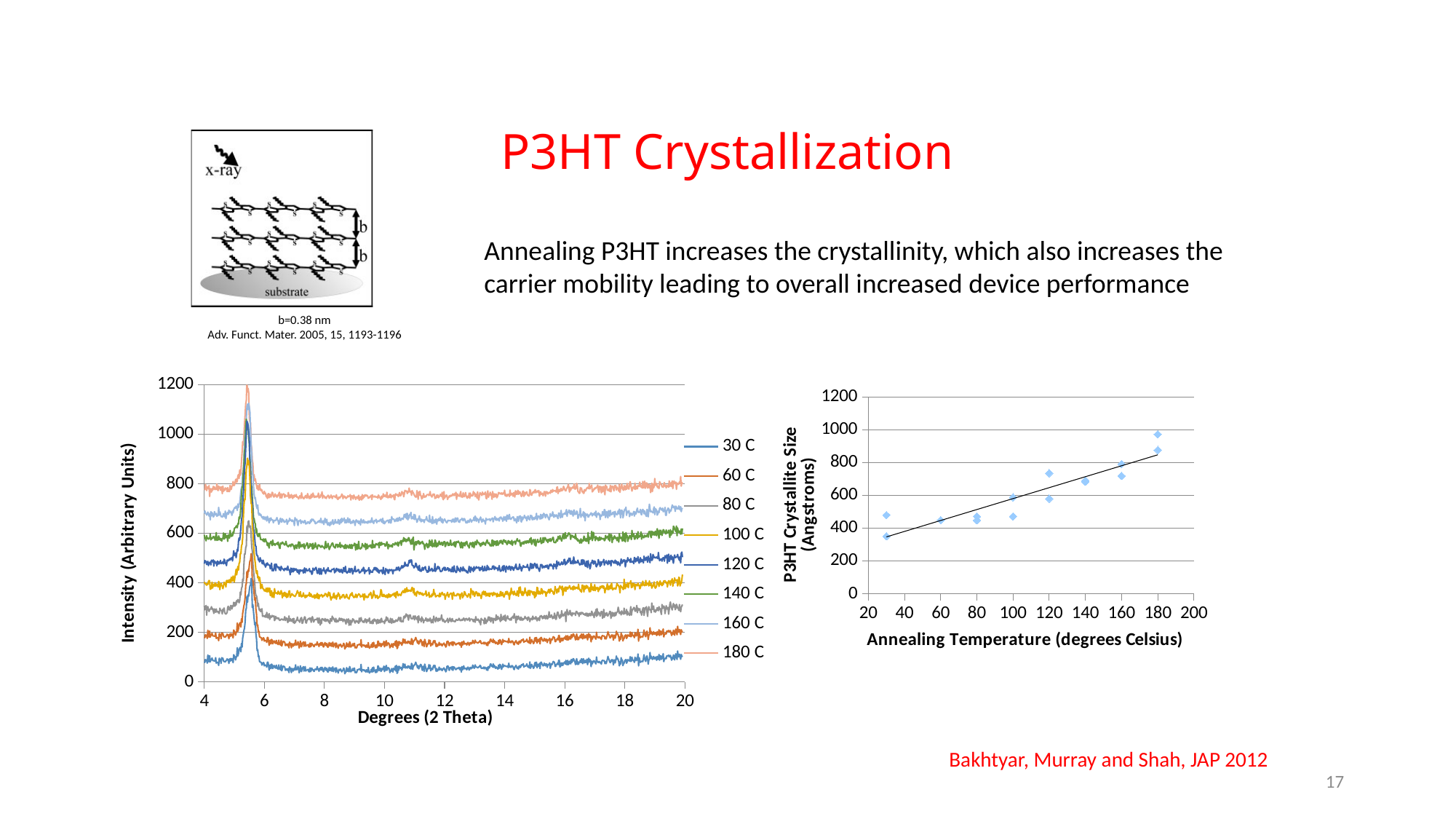
In the left chart, is the peak intensity of the 30 C series greater or less than 600? less In the right chart, are the crystallite size values at 180 degrees Celsius greater or less than 800 Angstroms? greater In the left chart, which series has the lowest baseline intensity? 30 C What kind of chart is the right chart (P3HT Crystallite Size vs Annealing Temperature)? scatter chart What is the x-axis label of the right chart? Annealing Temperature (degrees Celsius) In the right chart, at which annealing temperature is the largest crystallite size plotted? 180 In the left chart, is the peak intensity of the 180 C series greater or less than 1000? greater What kind of chart is the left chart (Intensity vs Degrees 2 Theta)? line chart In the right chart, do the crystallite size values rise or fall as annealing temperature increases? rise In the left chart, which series reaches the highest peak intensity? 180 C How many series does the legend of the left chart list? 8